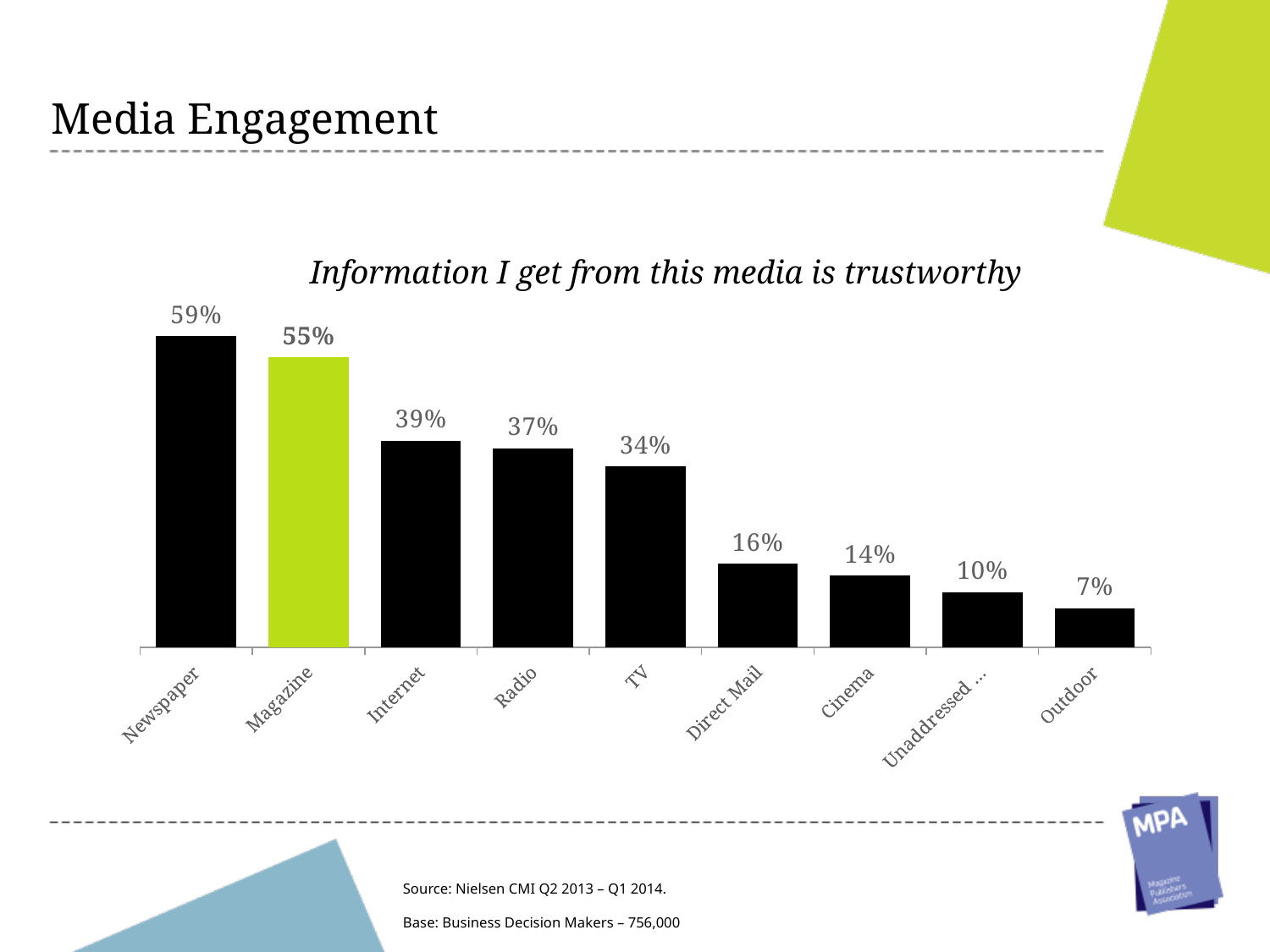
What percentage is shown for Direct Mail? 16% What kind of chart is shown on the slide? Bar chart What percentage is shown for Magazine? 55% Which is larger, the value for Cinema or the value for Outdoor? Cinema What percentage is shown for Radio? 37% What is the difference between the Newspaper and Magazine percentages? 4% Which bar is highlighted in green? Magazine What is the difference between the Internet and TV percentages? 5% Which media has the highest percentage? Newspaper How many media categories are shown in the chart? 9 What percentage is shown for Newspaper? 59% Which media has the lowest percentage? Outdoor